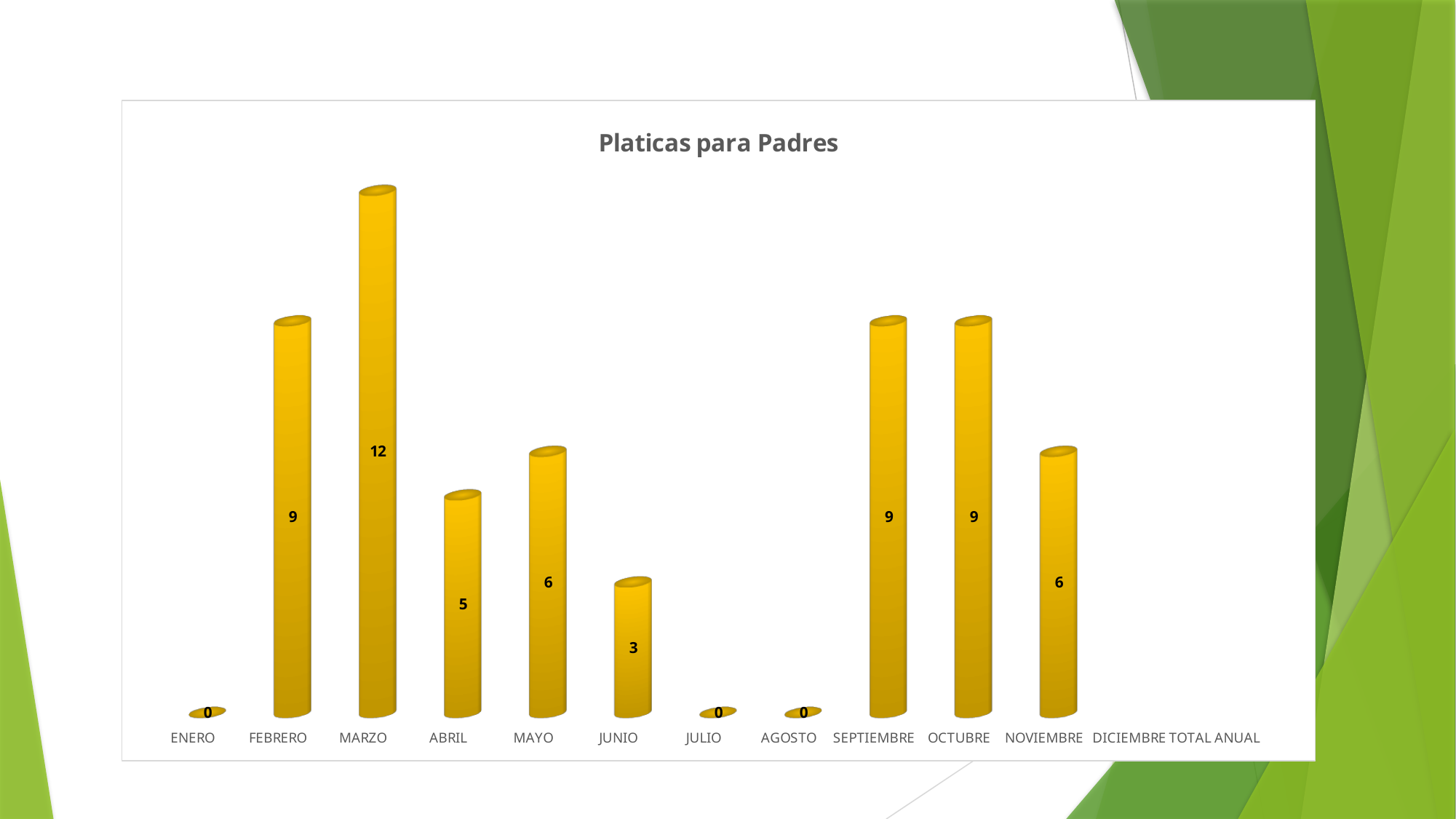
What is the difference between the values for MARZO and FEBRERO? 3 What is the value for JUNIO? 3 What is the value for AGOSTO? 0 What is the value for MARZO? 12 What is the title of the chart? Platicas para Padres Which month has the highest value? MARZO Which is larger, the value for MAYO or the value for ABRIL? MAYO What is the value for FEBRERO? 9 What type of chart is shown on the slide? bar chart What is the difference between the values for SEPTIEMBRE and NOVIEMBRE? 3 How many category labels are shown along the x axis? 13 What is the value for NOVIEMBRE? 6